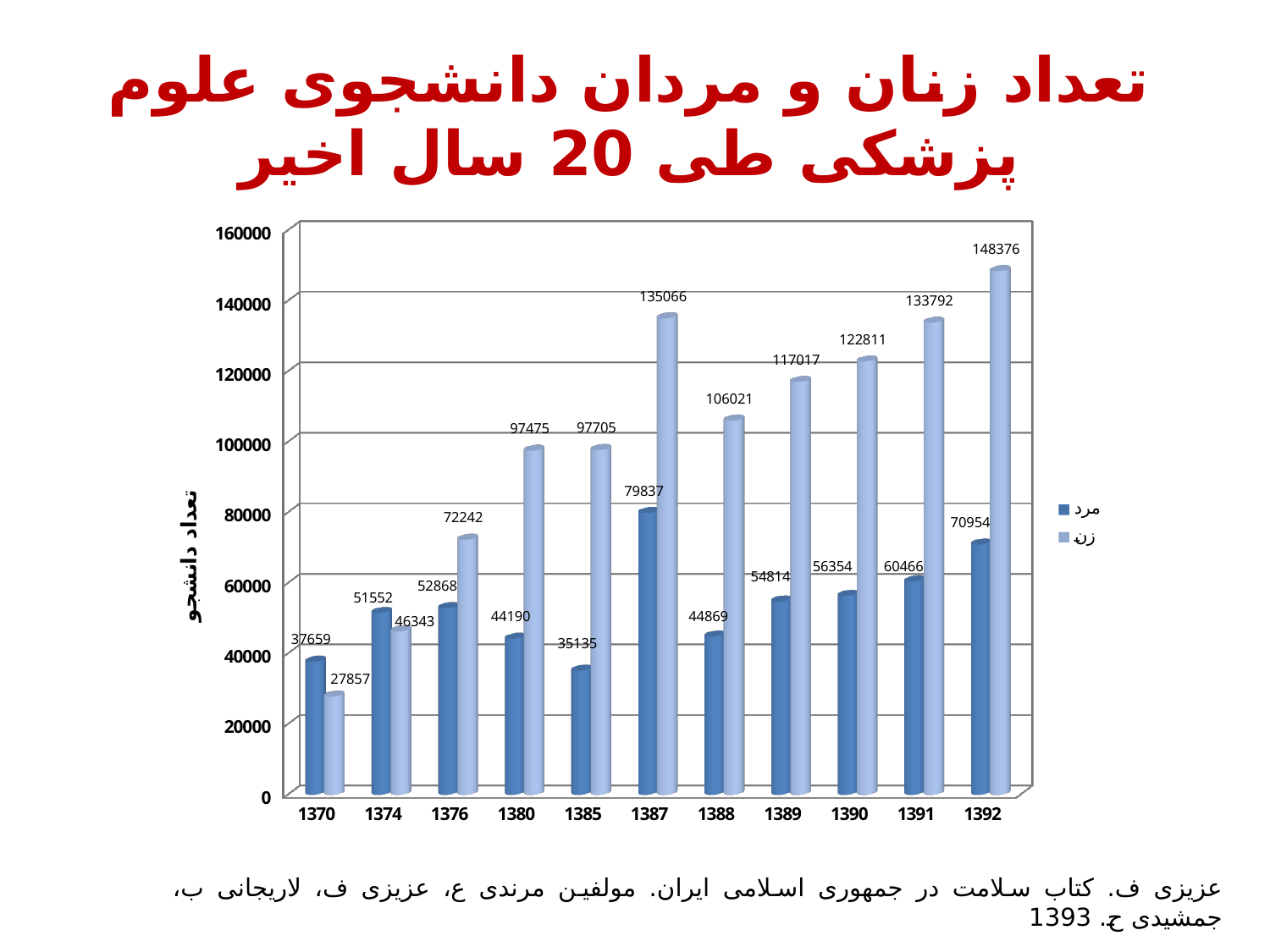
What is the difference between the زن (women) and مرد (men) values in 1392? 77422 What is the value for زن (women) in 1392? 148376 Do the values for زن (women) generally rise or fall from 1370 to 1392? rise How many years are shown on the x axis? 11 In which year is the value for مرد (men) lowest? 1385 In 1370, which is larger: the value for مرد (men) or زن (women)? مرد (men) What kind of chart is shown on the slide? bar chart What is the value for مرد (men) in 1370? 37659 How many series does the legend list? 2 In which year is the value for زن (women) highest? 1392 What is the value for زن (women) in 1387? 135066 Is the value for زن (women) in 1389 greater or less than 100000? greater